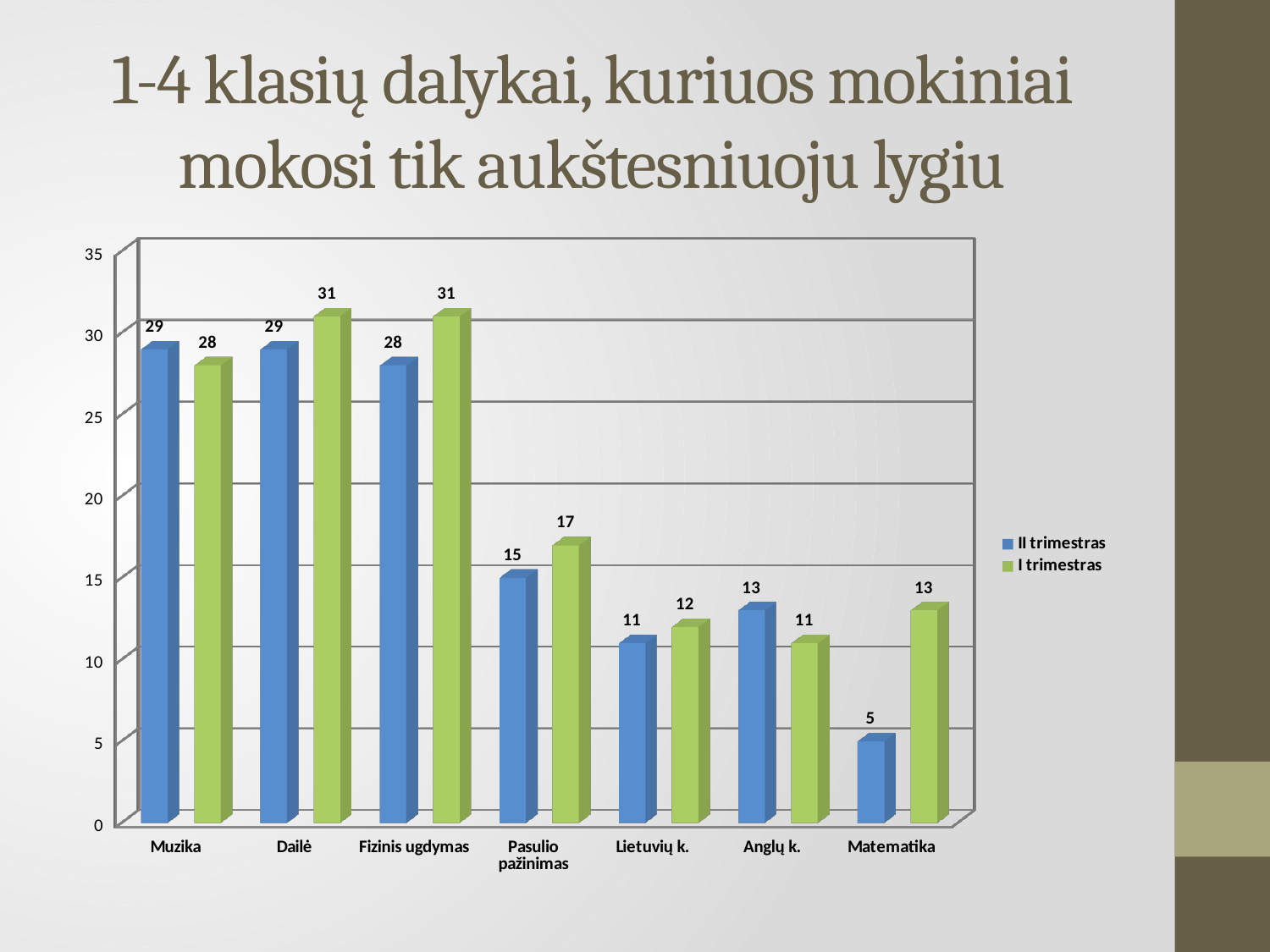
What is the difference between the I trimestras values for Dailė and Lietuvių k.? 19 What is the difference between the I trimestras and II trimestras values for Matematika? 8 What is the value for Matematika in the I trimestras series? 13 What is the value for Muzika in the II trimestras series? 29 Which category has the highest value in the I trimestras series? Dailė and Fizinis ugdymas (both 31) Which colour represents the I trimestras series in the legend? Green What is the value for Pasulio pažinimas in the I trimestras series? 17 Which category has the lowest value in the II trimestras series? Matematika How many categories are shown on the x axis? 7 How many series does the legend list? 2 Which is larger for Anglų k.: the II trimestras value or the I trimestras value? II trimestras What kind of chart is shown on the slide? Bar chart